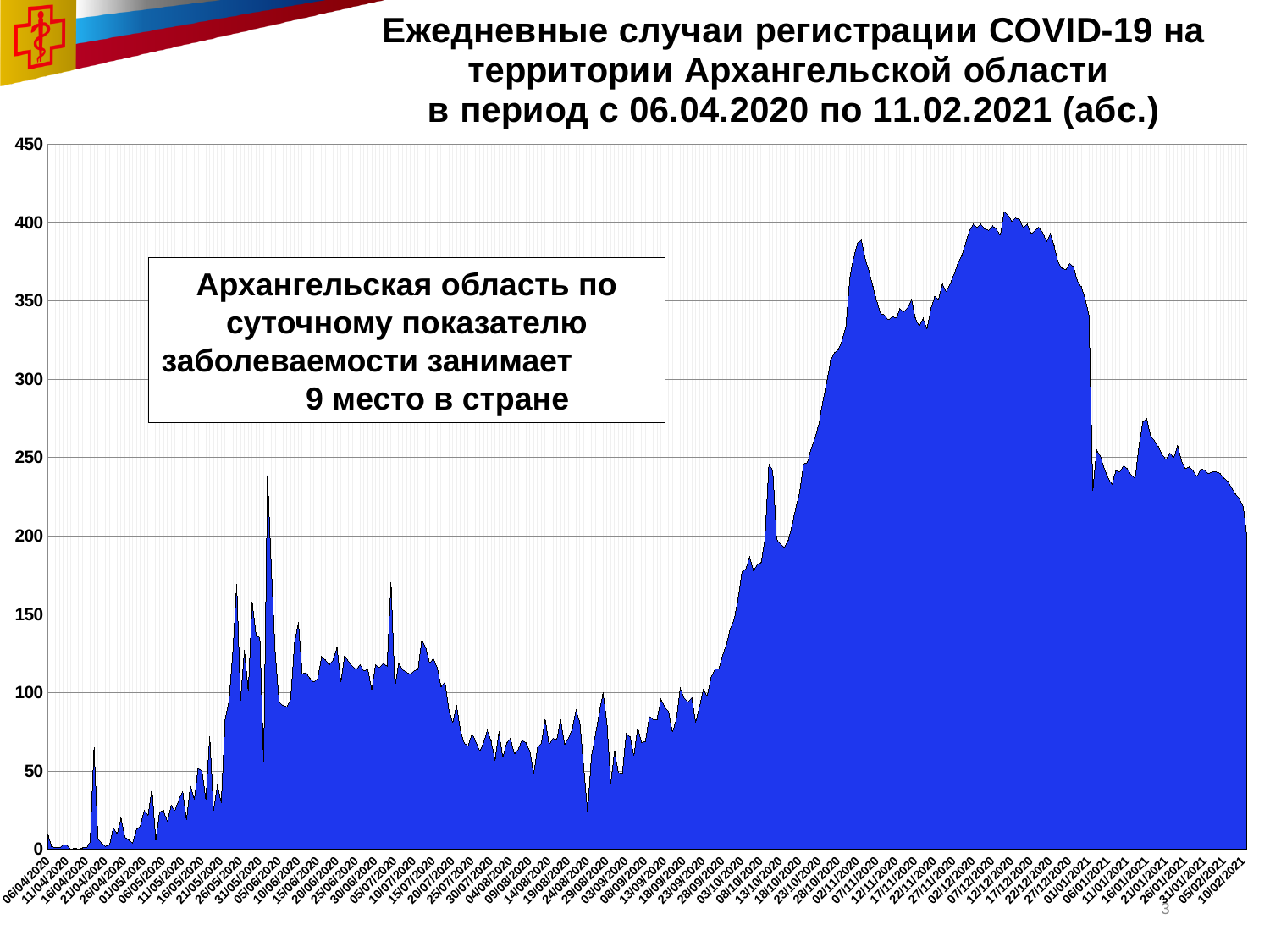
Is the value for 26/01/2021 greater or less than 200? greater Is the value for 17/12/2020 greater or less than 350? greater Do the values rise or fall between 28/09/2020 and 07/11/2020? rise What is the highest value shown on the vertical axis? 450 According to the text box on the chart, what place in the country does the Arkhangelsk region occupy by daily incidence? 9 место Is the highest value on the chart greater or less than 350? greater What kind of chart is shown on the slide? Area chart Do the values rise or fall between 17/12/2020 and 01/01/2021? fall